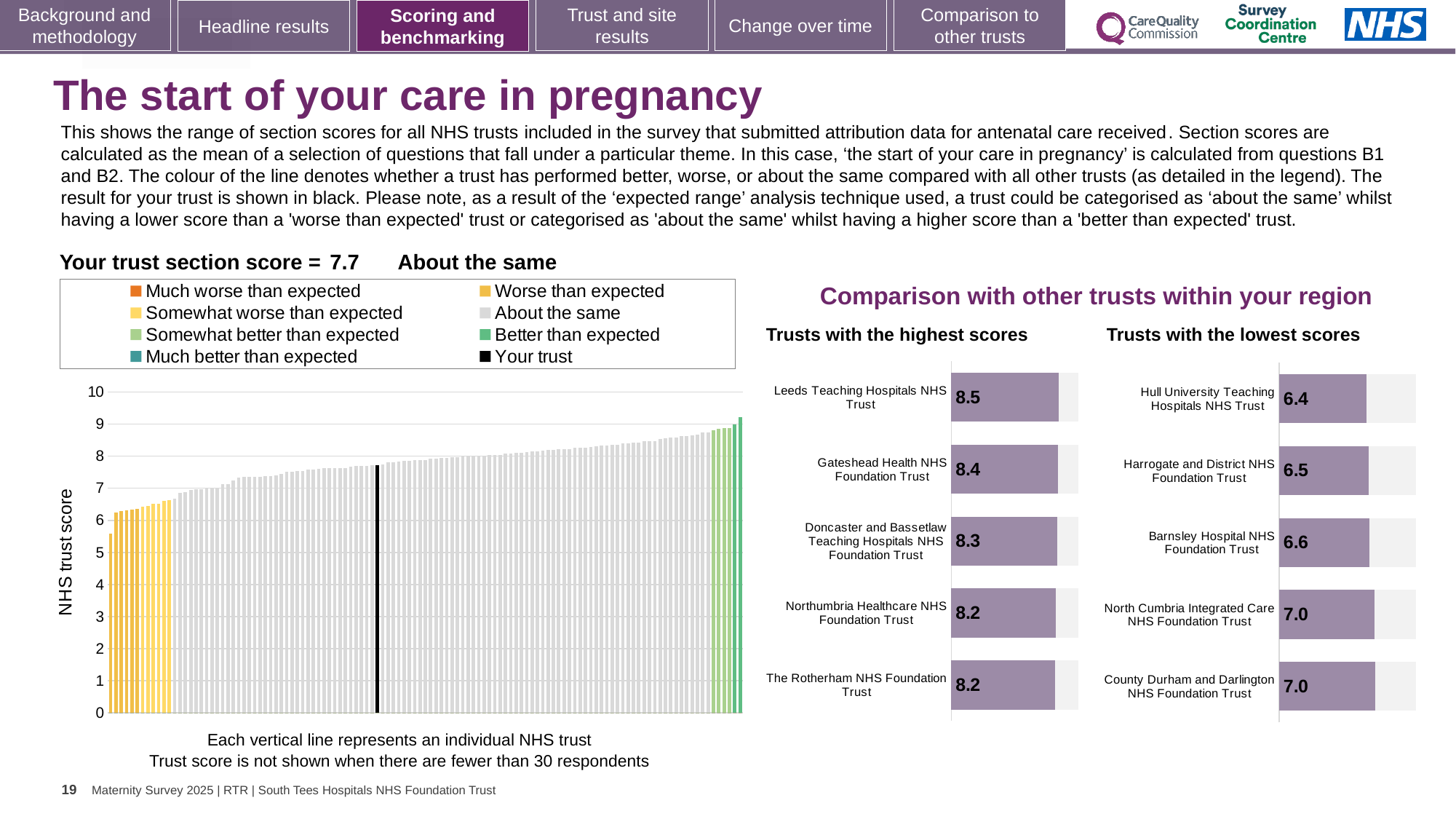
In the 'Trusts with the highest scores' chart, which trust has the highest score? Leeds Teaching Hospitals NHS Trust What kind of chart is the 'Trusts with the lowest scores' chart? Bar chart In the 'Trusts with the lowest scores' chart, what is the score for Hull University Teaching Hospitals NHS Trust? 6.4 In the 'Trusts with the highest scores' chart, what is the score for Leeds Teaching Hospitals NHS Trust? 8.5 What is your trust's section score for 'The start of your care in pregnancy'? 7.7 How many trusts are shown in the 'Trusts with the highest scores' chart? 5 In the 'Trusts with the lowest scores' chart, what is the difference between the scores of County Durham and Darlington NHS Foundation Trust and Hull University Teaching Hospitals NHS Trust? 0.6 In the 'Trusts with the lowest scores' chart, which trust has the lowest score? Hull University Teaching Hospitals NHS Trust In the 'Trusts with the highest scores' chart, what is the difference between the scores of Leeds Teaching Hospitals NHS Trust and Gateshead Health NHS Foundation Trust? 0.1 In the 'Trusts with the lowest scores' chart, which has the larger score: Barnsley Hospital NHS Foundation Trust or Harrogate and District NHS Foundation Trust? Barnsley Hospital NHS Foundation Trust In the main NHS trust score chart, is the value of the leftmost (lowest) bar greater or less than 6? less In the main NHS trust score chart, do the bar values rise or fall from left to right? rise